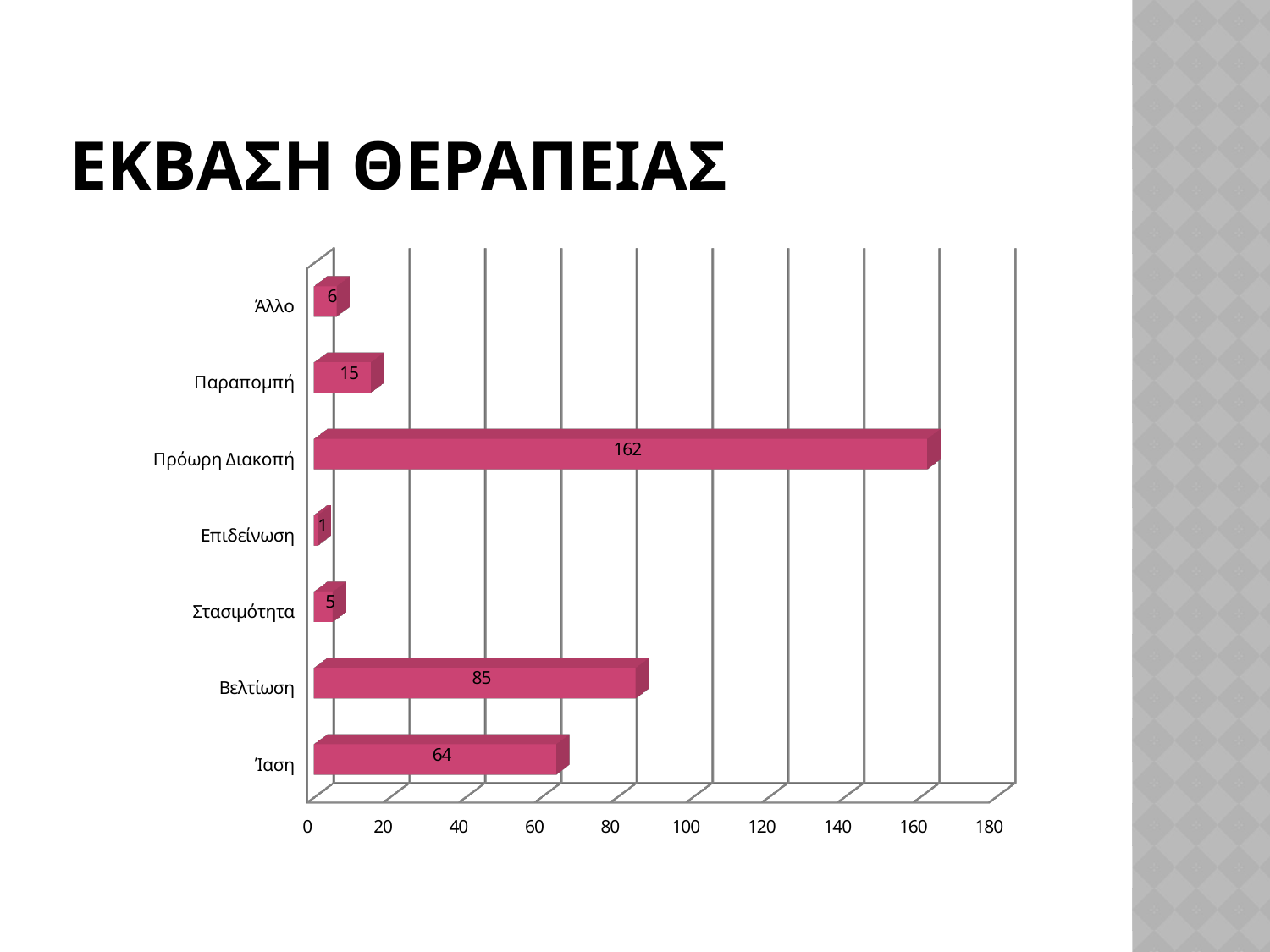
What is the difference between the values for Πρόωρη Διακοπή and Βελτίωση? 77 What is the value for Πρόωρη Διακοπή? 162 Is the value for Πρόωρη Διακοπή greater or less than 140? greater What is the value for Ίαση? 64 Which category has the highest value? Πρόωρη Διακοπή Which is larger, the value for Άλλο or the value for Στασιμότητα? Άλλο What kind of chart is shown on the slide? Bar chart Which category has the lowest value? Επιδείνωση How many categories are shown in the chart? 7 What is the value for Παραπομπή? 15 What is the difference between the values for Βελτίωση and Ίαση? 21 What is the value for Βελτίωση? 85